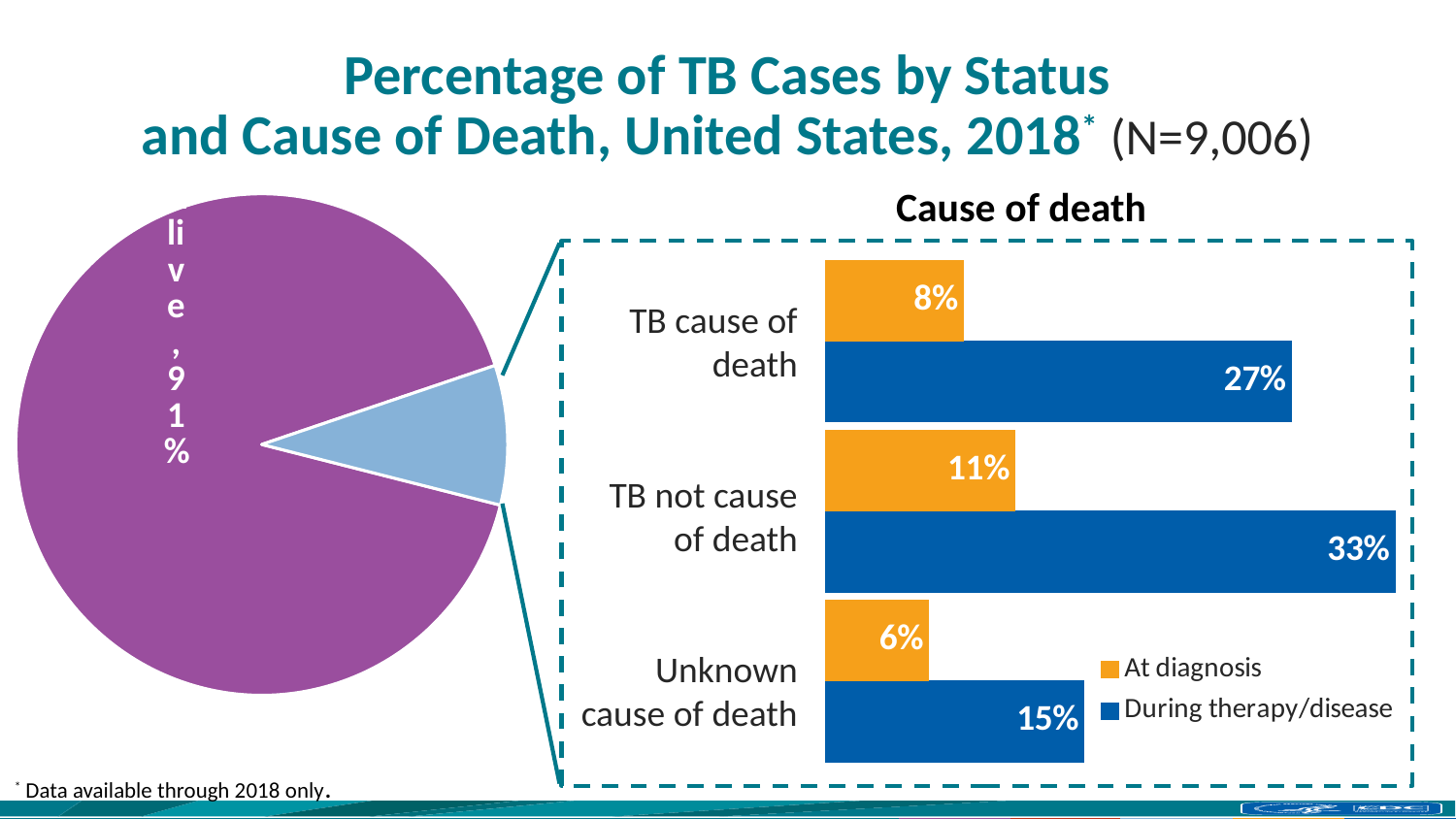
In the Cause of death bar chart, what is the value for Unknown cause of death in the At diagnosis series? 6% In the Cause of death bar chart, what is the value for TB not cause of death in the At diagnosis series? 11% What percentage is printed on the large purple slice of the pie chart on the left? 91% How many categories does the Cause of death bar chart show? 3 What kind of chart is the Cause of death chart on the right of the slide? Bar chart In the Cause of death bar chart, which is larger for TB not cause of death: the At diagnosis value or the During therapy/disease value? During therapy/disease How many series does the legend of the Cause of death bar chart list? 2 In the Cause of death bar chart, which category has the lowest value in the At diagnosis series? Unknown cause of death In the Cause of death bar chart, what is the difference between the During therapy/disease and At diagnosis values for TB cause of death? 19% In the Cause of death bar chart, which category has the highest value in the During therapy/disease series? TB not cause of death In the Cause of death bar chart, what is the value for TB cause of death in the During therapy/disease series? 27% In the Cause of death bar chart, what is the value for Unknown cause of death in the During therapy/disease series? 15%